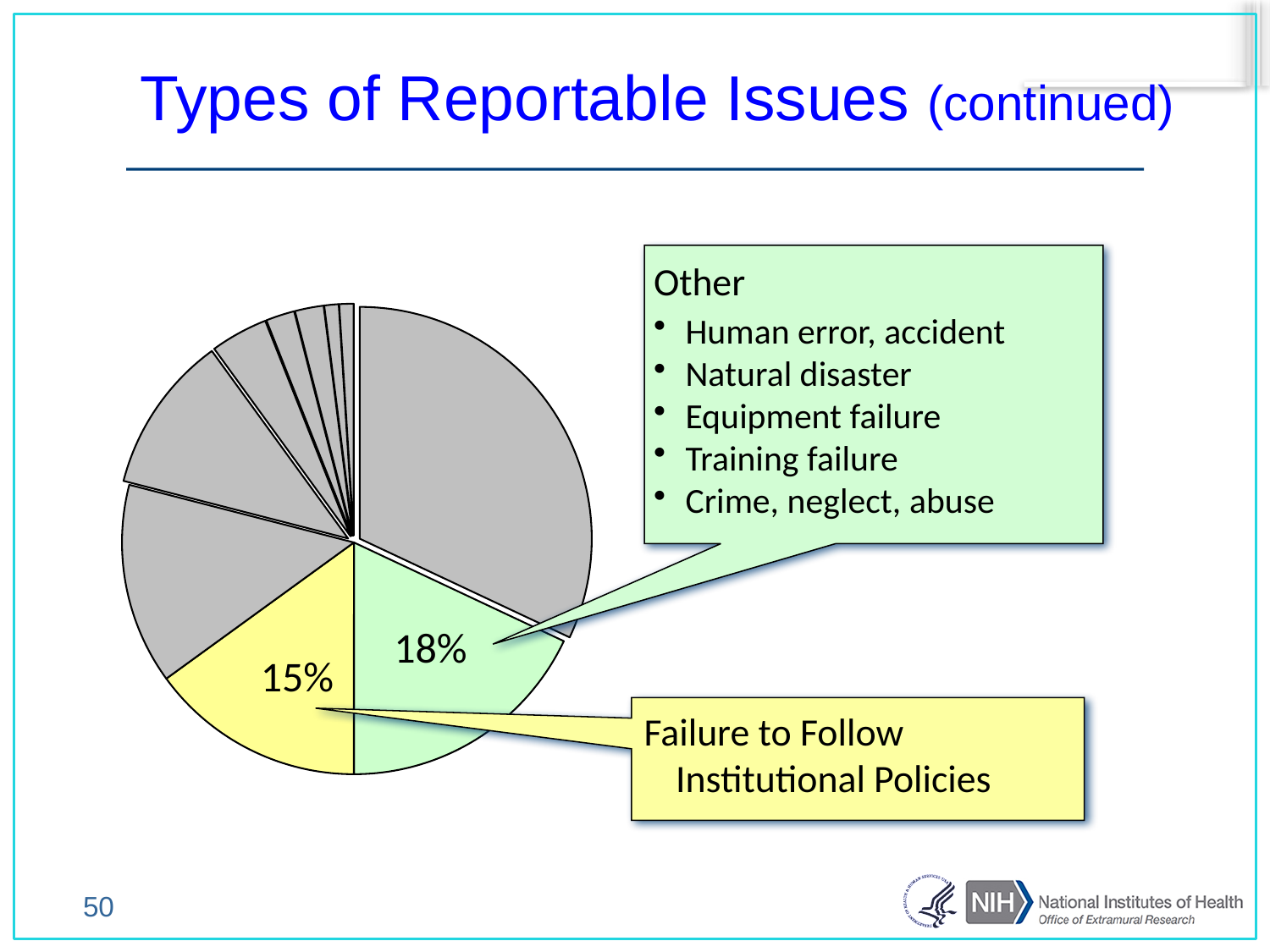
What is the title of the slide containing the pie chart? Types of Reportable Issues (continued) By how many percentage points does the Other slice exceed the Failure to Follow Institutional Policies slice? 3 percentage points What percentage of the pie chart is the Other slice? 18% What percentage of the pie chart is the Failure to Follow Institutional Policies slice? 15% Which labelled slice is larger, Other or Failure to Follow Institutional Policies? Other What kind of chart is shown on the slide? Pie chart What colour is the Failure to Follow Institutional Policies slice in the pie chart? Yellow What is the combined share of the Other and Failure to Follow Institutional Policies slices? 33%